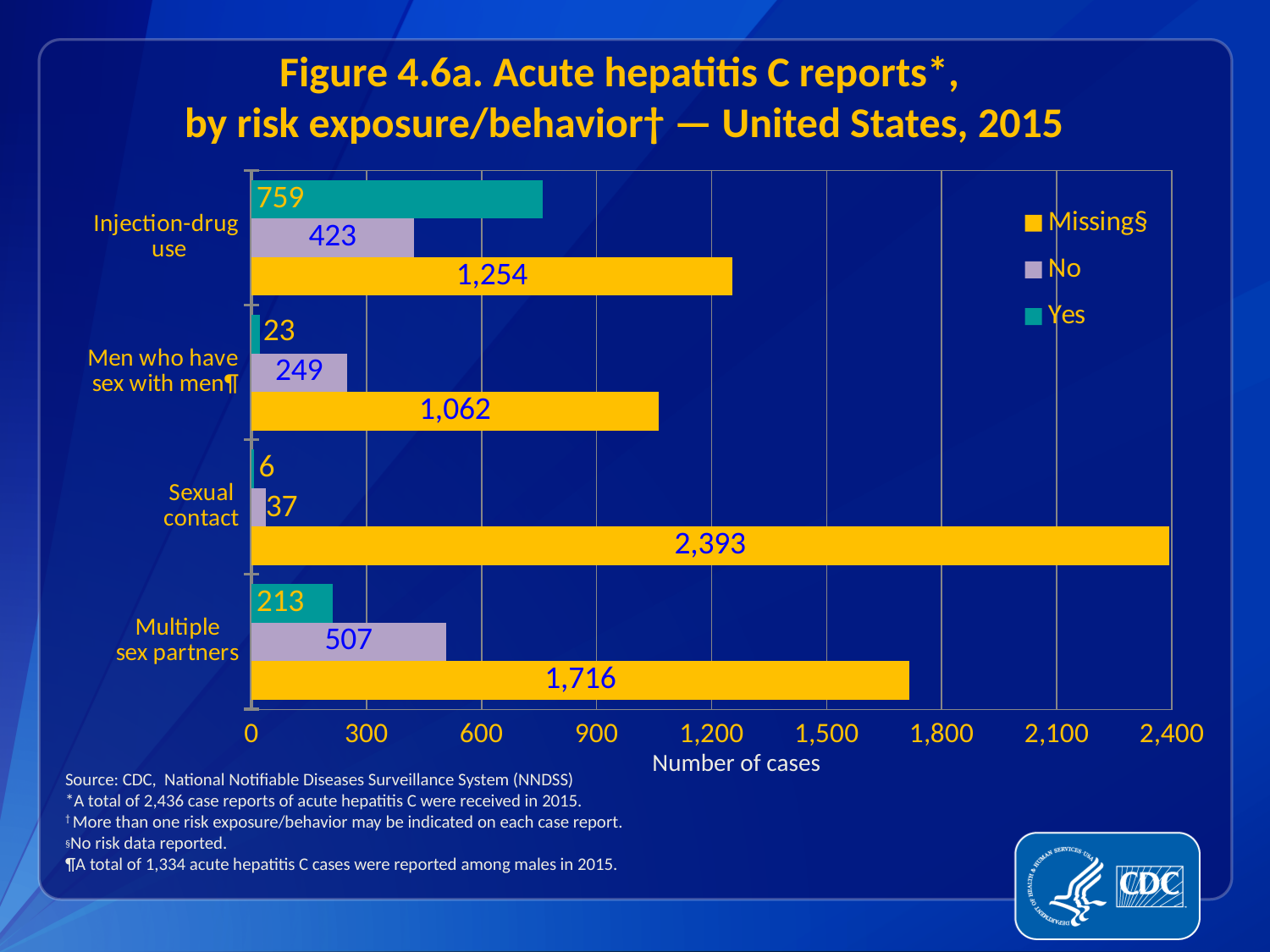
Which is larger: the 'No' value for Injection-drug use or the 'No' value for Men who have sex with men? Injection-drug use Which risk exposure category has the lowest 'Yes' value? Sexual contact How many series does the legend list? 3 How many risk exposure/behavior categories are shown on the chart? 4 What is the label of the x axis? Number of cases What is the number of cases for 'No' in the Multiple sex partners category? 507 Which risk exposure category has the highest 'Missing' value? Sexual contact What is the number of cases for 'Yes' in the Injection-drug use category? 759 What is the difference between the 'Missing' values for Multiple sex partners and Injection-drug use? 462 What kind of chart is shown on the slide? Bar chart What is the number of cases for 'Missing' in the Sexual contact category? 2,393 What is the number of cases for 'Yes' in the Men who have sex with men category? 23